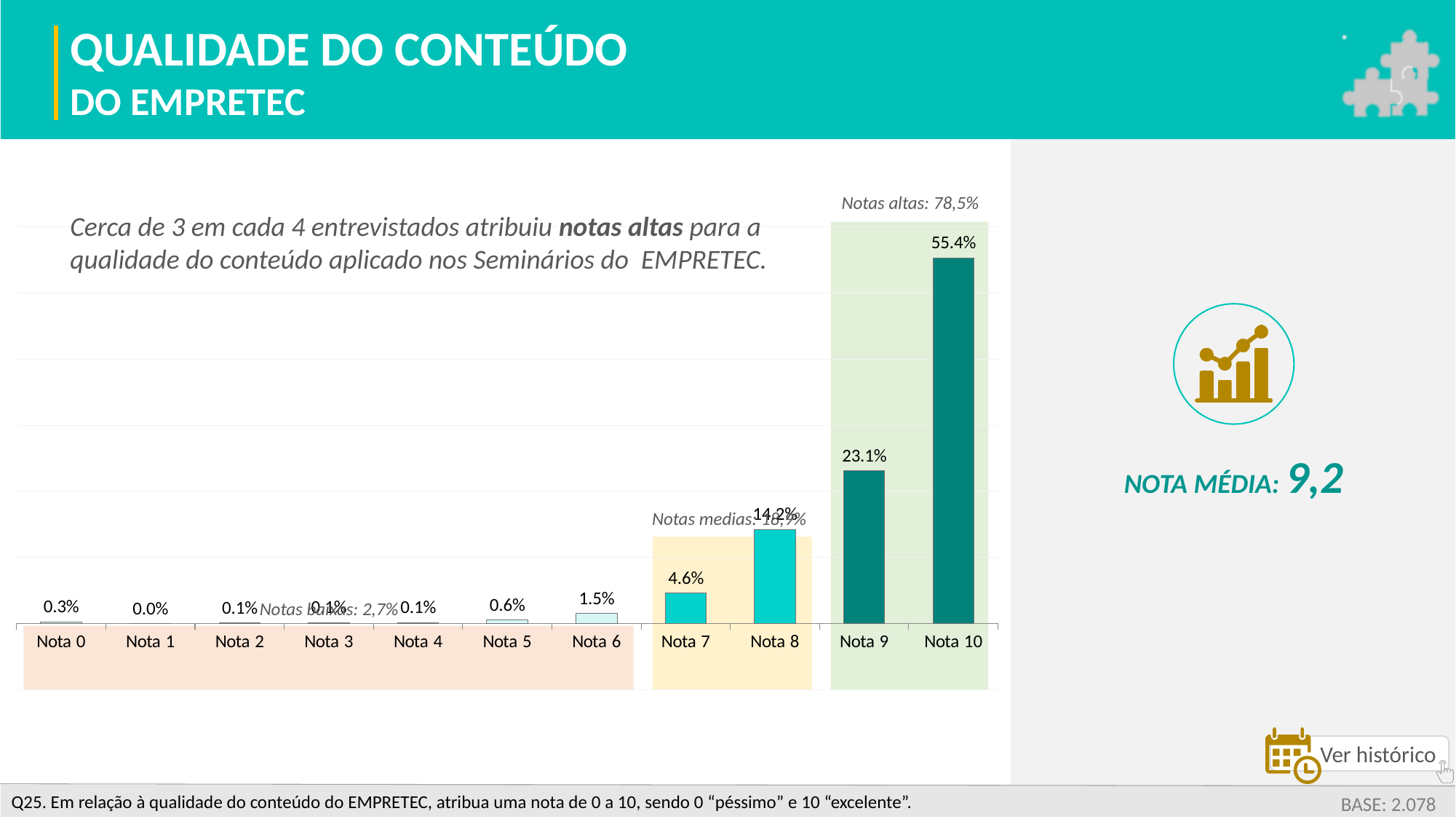
Which category has the highest value? Nota 10 What is the difference between the values for Nota 10 and Nota 9? 32.3% What is the value for Nota 6? 1.5% What is the share of 'Notas altas' shown above the green highlighted group? 78,5% What is the value for Nota 7? 4.6% What kind of chart is shown on the slide? Bar chart Which category has the lowest value? Nota 1 What is the value for Nota 10? 55.4% What is the value for Nota 8? 14.2% How many categories (notas) are shown on the x axis? 11 Which is larger, the value for Nota 8 or the value for Nota 7? Nota 8 What is the value for Nota 9? 23.1%